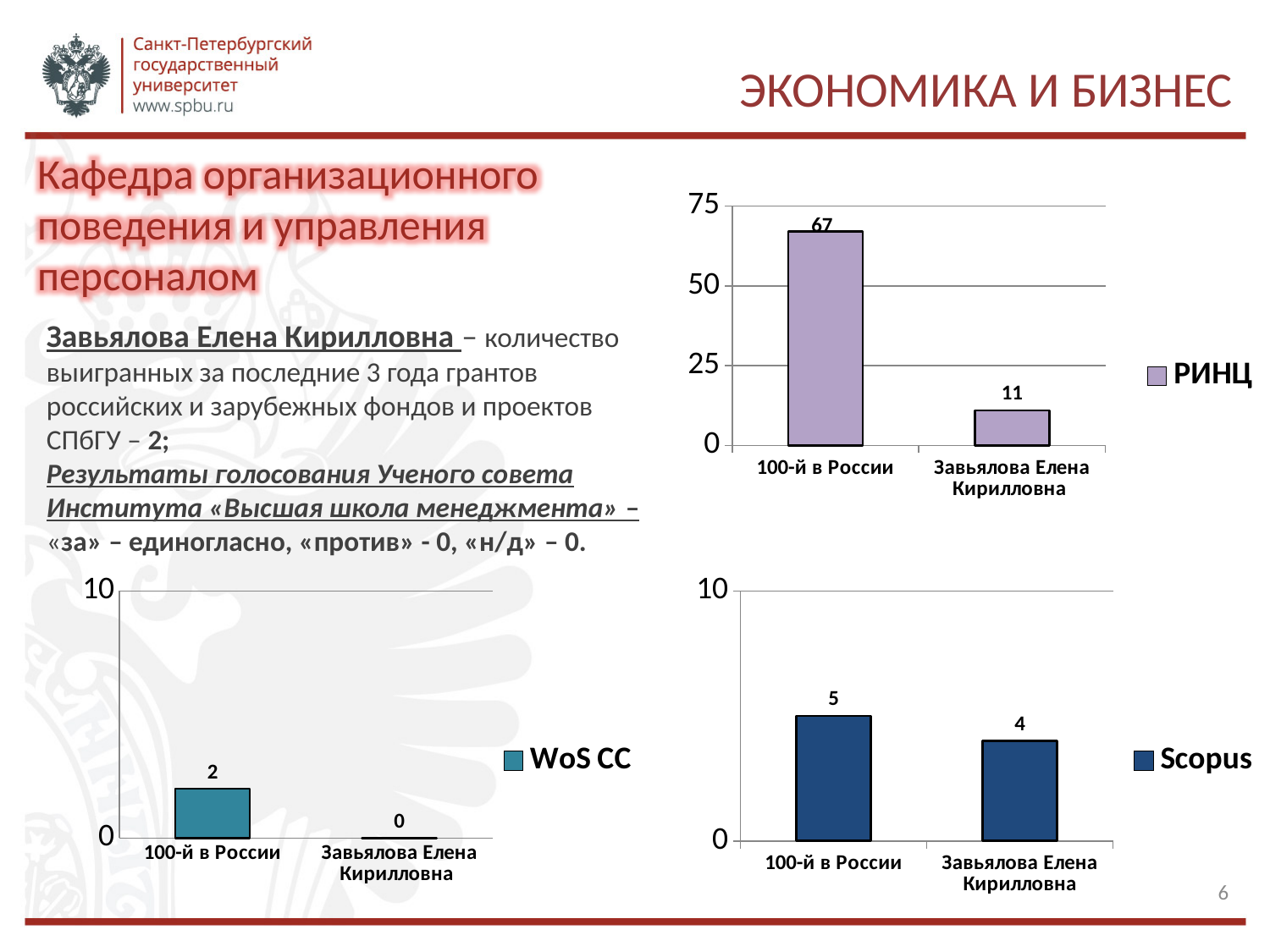
In the WoS CC chart (bottom left), what is the value for Завьялова Елена Кирилловна? 0 In the Scopus chart (bottom right), what is the difference between the values for 100-й в России and Завьялова Елена Кирилловна? 1 What type of chart is the Scopus chart (bottom right)? bar chart In the РИНЦ chart (top right), what is the value for Завьялова Елена Кирилловна? 11 In the РИНЦ chart (top right), is the value for 100-й в России greater or less than 50? greater In the Scopus chart (bottom right), what is the value for 100-й в России? 5 In the РИНЦ chart (top right), what is the difference between the values for 100-й в России and Завьялова Елена Кирилловна? 56 How many categories are shown in the WoS CC chart (bottom left)? 2 In the WoS CC chart (bottom left), what is the value for 100-й в России? 2 In the РИНЦ chart (top right), what is the value for 100-й в России? 67 In the Scopus chart (bottom right), what is the value for Завьялова Елена Кирилловна? 4 In the Scopus chart (bottom right), which category has the higher value? 100-й в России